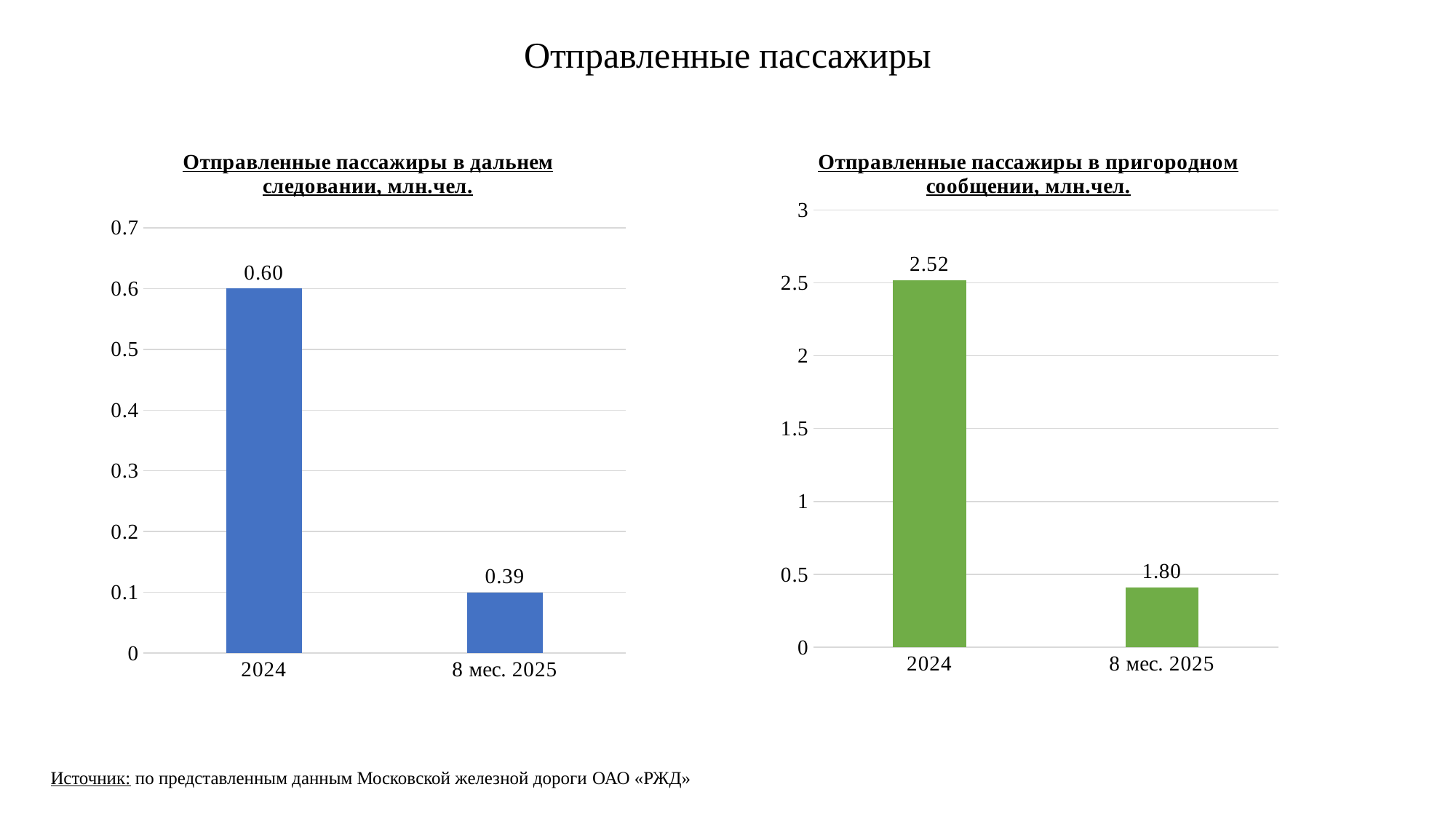
What kind of chart is the right chart (пригородном сообщении)? bar chart In the right chart (пригородном сообщении), which category has the lowest value? 8 мес. 2025 In the left chart (дальнем следовании), which category has the highest value? 2024 In the chart 'Отправленные пассажиры в дальнем следовании, млн.чел.', what is the value for 8 мес. 2025? 0.39 In the chart 'Отправленные пассажиры в дальнем следовании, млн.чел.', what is the value for 2024? 0.60 In the chart 'Отправленные пассажиры в пригородном сообщении, млн.чел.', what is the value for 8 мес. 2025? 1.80 In the right chart (пригородном сообщении), which is larger: the value for 2024 or the value for 8 мес. 2025? 2024 In the right chart (пригородном сообщении), what is the difference between the 2024 value and the 8 мес. 2025 value? 0.72 In the left chart (дальнем следовании), what is the difference between the 2024 value and the 8 мес. 2025 value? 0.21 In the chart 'Отправленные пассажиры в пригородном сообщении, млн.чел.', what is the value for 2024? 2.52 How many categories are shown in the left chart (дальнем следовании)? 2 What colour are the bars in the right chart (пригородном сообщении)? green